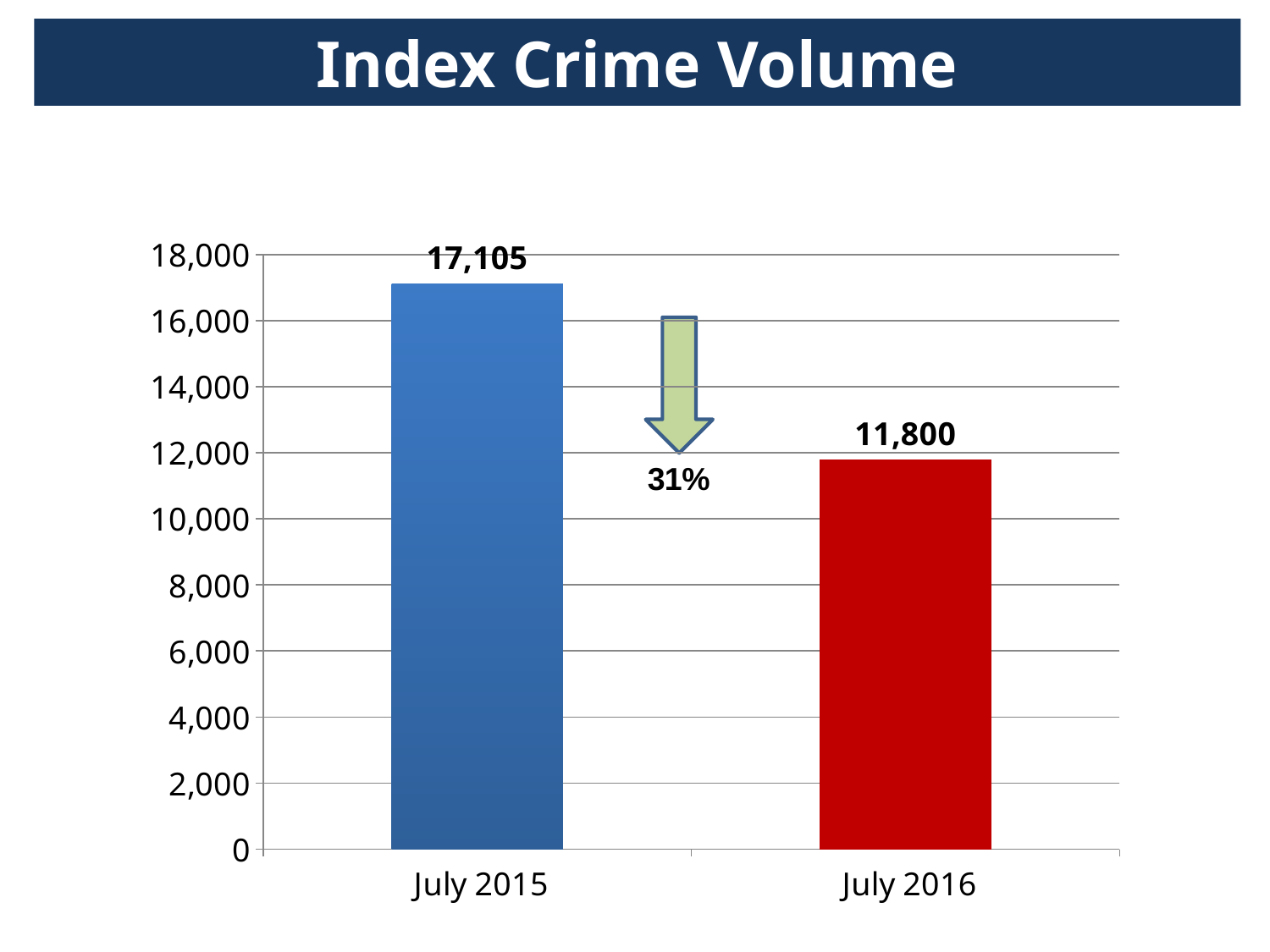
Which month has the higher index crime volume? July 2015 How many categories are shown on the x axis? 2 Which month has the lower index crime volume? July 2016 What is the index crime volume for July 2015? 17,105 What kind of chart is shown on the slide? bar chart What is the index crime volume for July 2016? 11,800 What is the difference between the July 2015 and July 2016 index crime volumes? 5,305 What is the title of the chart? Index Crime Volume Is the value for July 2016 greater or less than 12,000? less Is the value for July 2015 greater or less than 16,000? greater What percentage change is shown next to the arrow between the two bars? 31% Do the values rise or fall from July 2015 to July 2016? fall